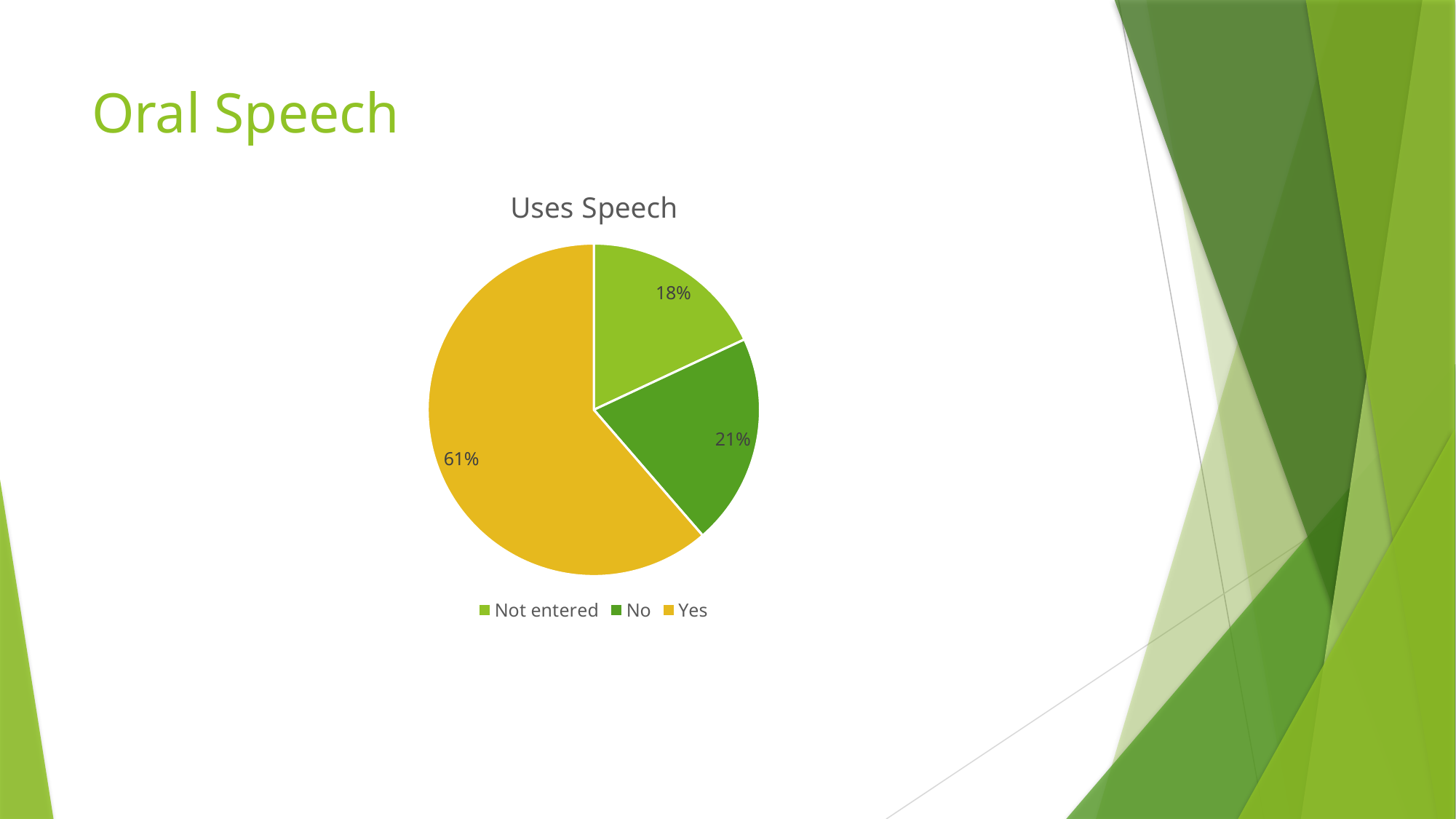
What kind of chart is shown on the slide? pie chart What share of the pie is labelled "Yes"? 61% Which category has the largest slice of the pie? Yes What is the title of the chart? Uses Speech What is the difference in percentage points between the "Yes" slice and the "No" slice? 40 Which category has the smallest slice of the pie? Not entered Which slice is larger, "No" or "Not entered"? No How many slices does the pie chart have? 3 What colour is the "Yes" slice? yellow What share of the pie is labelled "No"? 21% What share of the pie is labelled "Not entered"? 18% How many entries does the legend list? 3